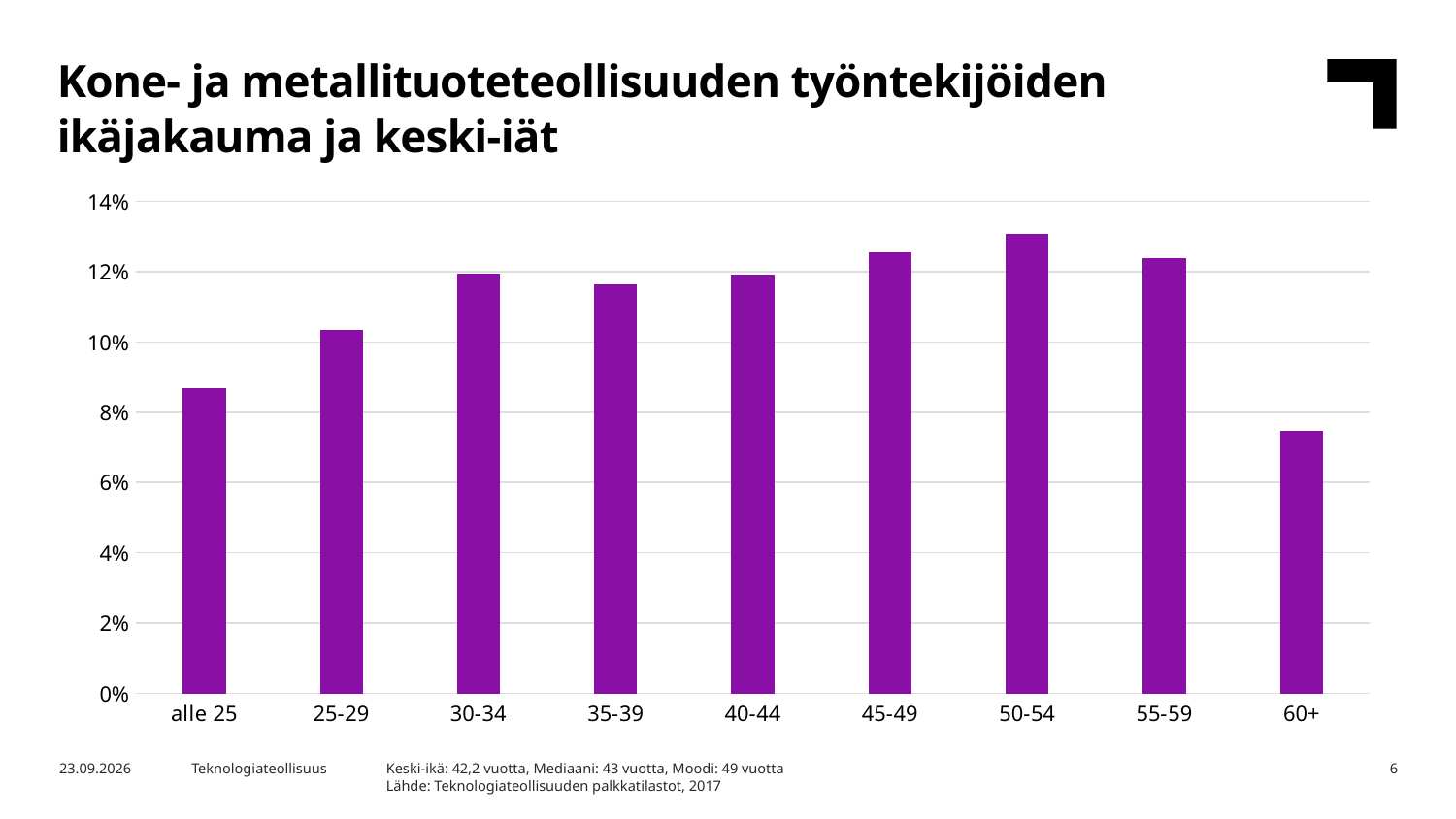
Which has a larger value, 50-54 or 60+? 50-54 Is the value for 50-54 greater or less than 12%? greater Is the value for alle 25 greater or less than 10%? less What is the title of the chart on the slide? Kone- ja metallituoteteollisuuden työntekijöiden ikäjakauma ja keski-iät Which age group has the lowest share of workers? 60+ Is the value for 25-29 greater or less than 10%? greater How many age groups are shown on the x axis? 9 Which has a larger value, alle 25 or 25-29? 25-29 What kind of chart is shown on the slide? bar chart Which age group has the highest share of workers? 50-54 Do the values rise or fall from 50-54 to 60+? fall